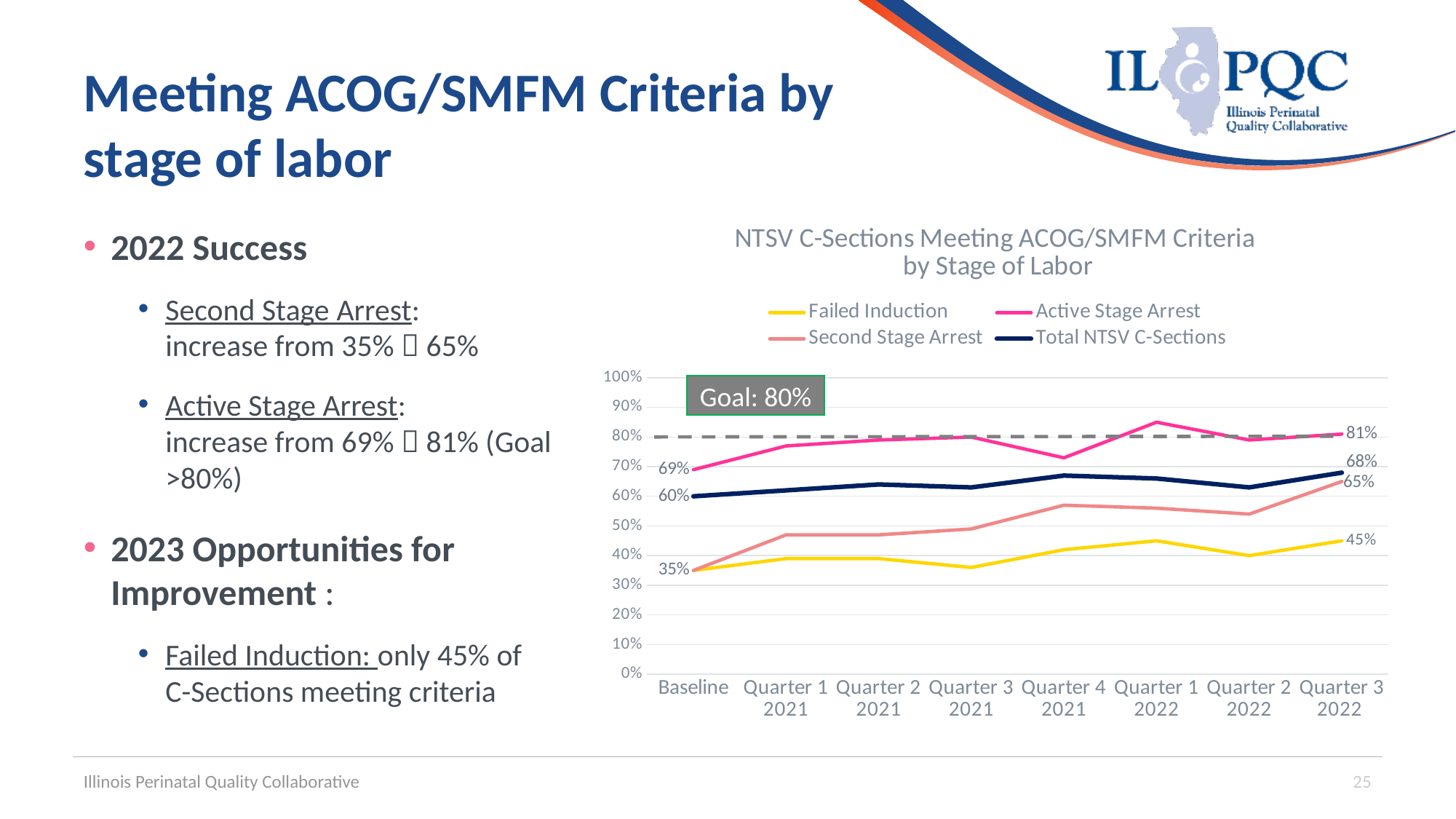
What is the value for Total NTSV C-Sections at Quarter 3 2022? 68% What kind of chart is shown on the slide? Line chart What is the value for Active Stage Arrest at Baseline? 69% How many series does the legend of the chart list? 4 What is the value for Active Stage Arrest at Quarter 3 2022? 81% Which series has the highest value at Quarter 3 2022? Active Stage Arrest What is the value for Second Stage Arrest at Quarter 3 2022? 65% What is the value for Failed Induction at Quarter 3 2022? 45% By how many percentage points did Active Stage Arrest increase from Baseline to Quarter 3 2022? 12 percentage points How many time points are shown along the x axis of the chart? 8 What is the value for Total NTSV C-Sections at Baseline? 60% Is the value for Failed Induction at Quarter 1 2022 greater or less than 50%? less